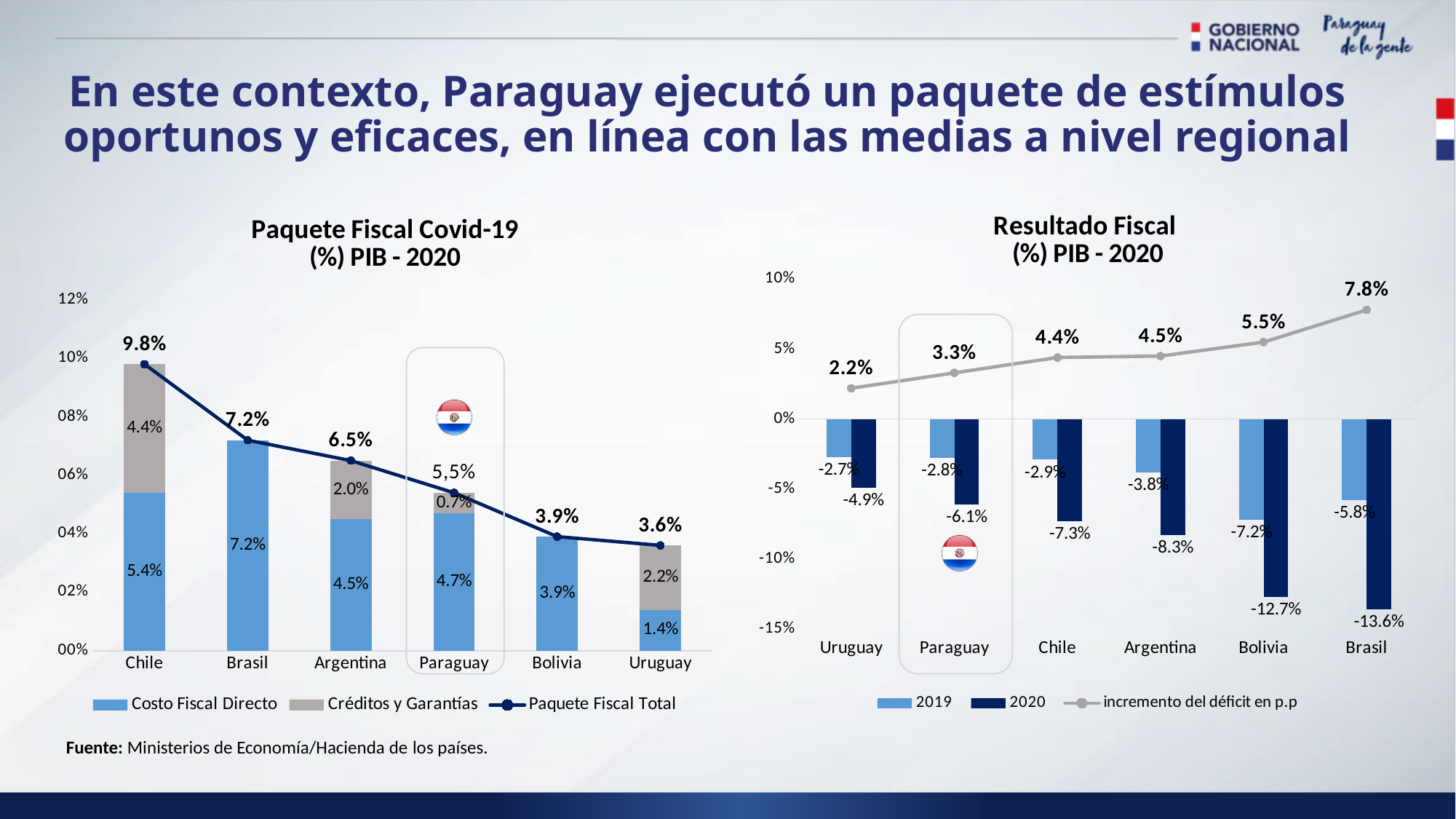
In the 'Paquete Fiscal Covid-19 (%) PIB - 2020' chart, what is the Costo Fiscal Directo value for Argentina? 4.5% In the 'Paquete Fiscal Covid-19 (%) PIB - 2020' chart, which country has the lowest Paquete Fiscal Total? Uruguay In the 'Resultado Fiscal (%) PIB - 2020' chart, which country has the lowest 2020 value? Brasil In the 'Paquete Fiscal Covid-19 (%) PIB - 2020' chart, what is the Paquete Fiscal Total value for Chile? 9.8% In the 'Resultado Fiscal (%) PIB - 2020' chart, which is larger, the 2019 value for Uruguay or the 2019 value for Bolivia? Uruguay In the 'Paquete Fiscal Covid-19 (%) PIB - 2020' chart, what is the Créditos y Garantías value for Uruguay? 2.2% In the 'Paquete Fiscal Covid-19 (%) PIB - 2020' chart, what is the difference between the Paquete Fiscal Total of Chile and Brasil? 2.6% In the 'Paquete Fiscal Covid-19 (%) PIB - 2020' chart, how many series does the legend list? 3 In the 'Resultado Fiscal (%) PIB - 2020' chart, how many countries are shown on the x axis? 6 In the 'Resultado Fiscal (%) PIB - 2020' chart, what is the 'incremento del déficit en p.p' value for Brasil? 7.8% In the 'Resultado Fiscal (%) PIB - 2020' chart, what is the 2020 value for Paraguay? -6.1% In the 'Paquete Fiscal Covid-19 (%) PIB - 2020' chart, does the Paquete Fiscal Total line rise or fall from Chile to Uruguay? Fall